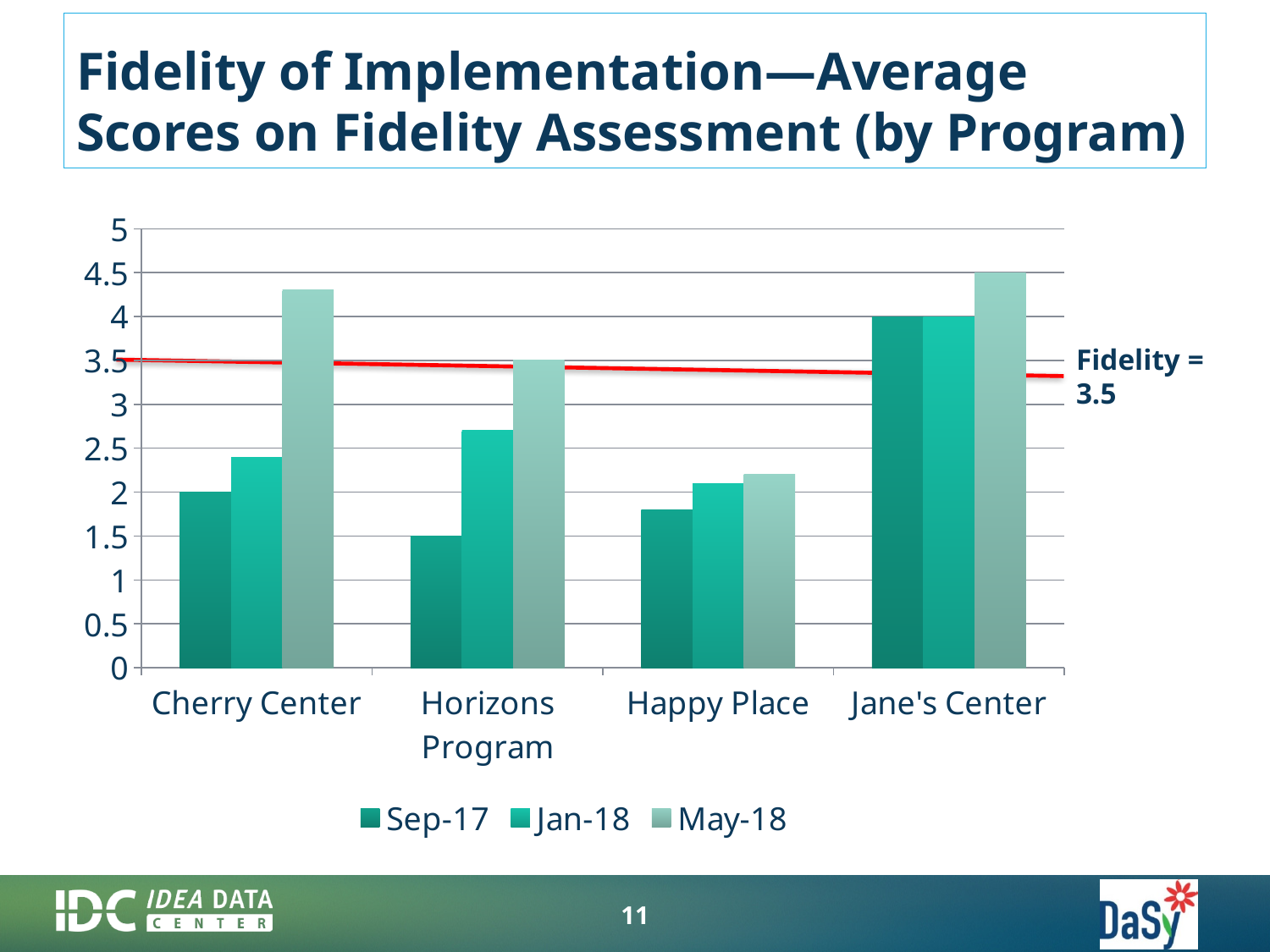
Which program has the lowest Sep-17 value? Horizons Program Which program has the highest May-18 value? Jane's Center How many series does the legend list? 3 What does the label next to the red horizontal line say? Fidelity = 3.5 What is the difference between the May-18 and Sep-17 values for Jane's Center? 0.5 Is the May-18 value for Happy Place greater or less than 3? less Is the May-18 value for Cherry Center greater or less than 4? greater What kind of chart is shown on the slide? bar chart What is the Sep-17 value for Horizons Program? 1.5 What is the Sep-17 value for Cherry Center? 2 What is the May-18 value for Jane's Center? 4.5 How many programs are shown on the x axis? 4